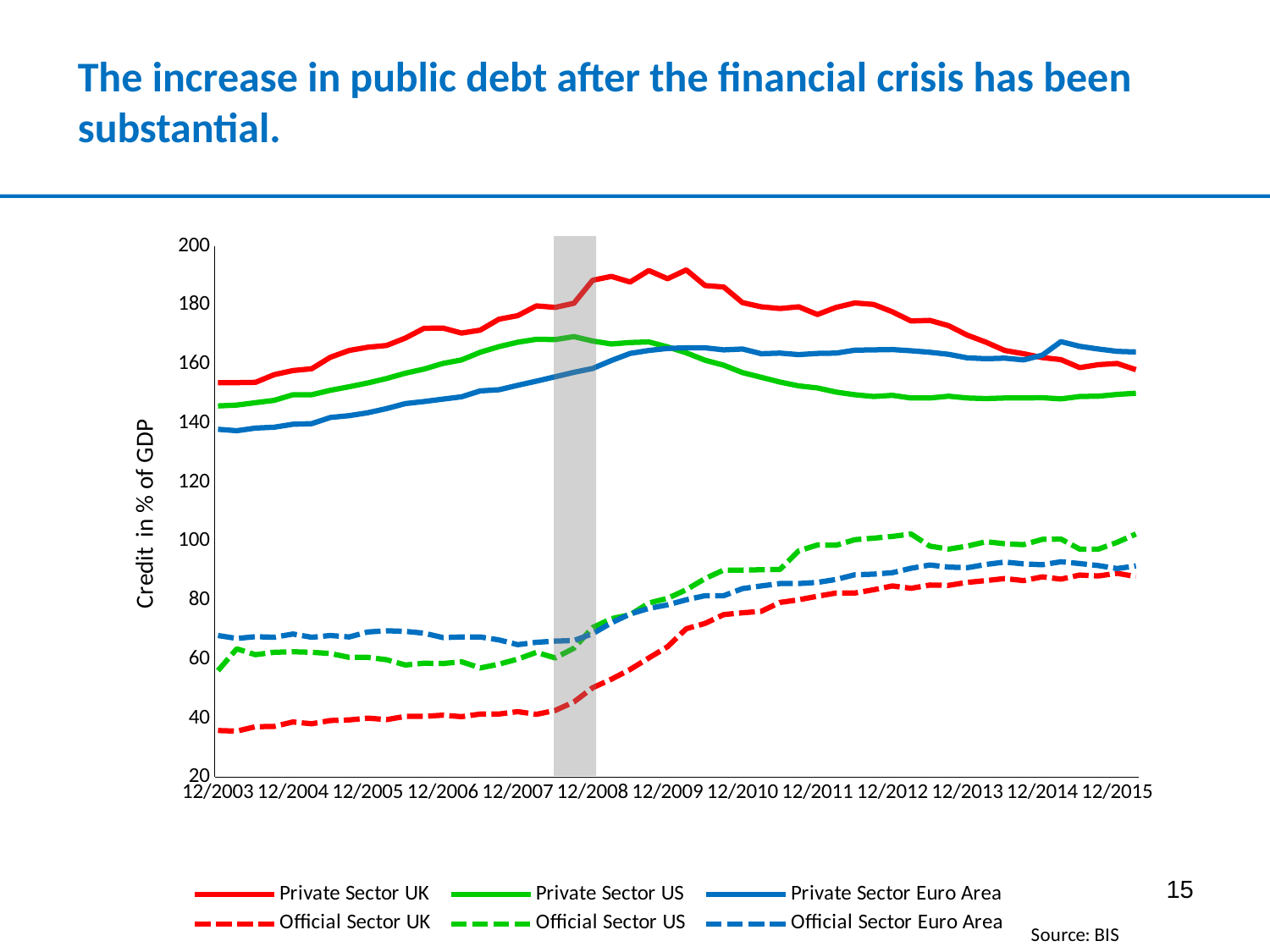
At 12/2003, which is higher: Official Sector Euro Area or Official Sector UK? Official Sector Euro Area Does the Private Sector US series rise or fall between 12/2009 and 12/2012? fall Which series has the highest value at 12/2009? Private Sector UK Is the value for Private Sector Euro Area at 12/2003 greater or less than 120? greater Does the Official Sector UK series rise or fall between 12/2003 and 12/2015? rise Is the value for Official Sector UK at 12/2003 greater or less than 40? less Is the value for Private Sector UK at 12/2003 greater or less than 140? greater What kind of chart is shown on the slide? line chart How many series does the legend list? 6 What is the title of the vertical axis? Credit in % of GDP What source is cited for the chart? BIS